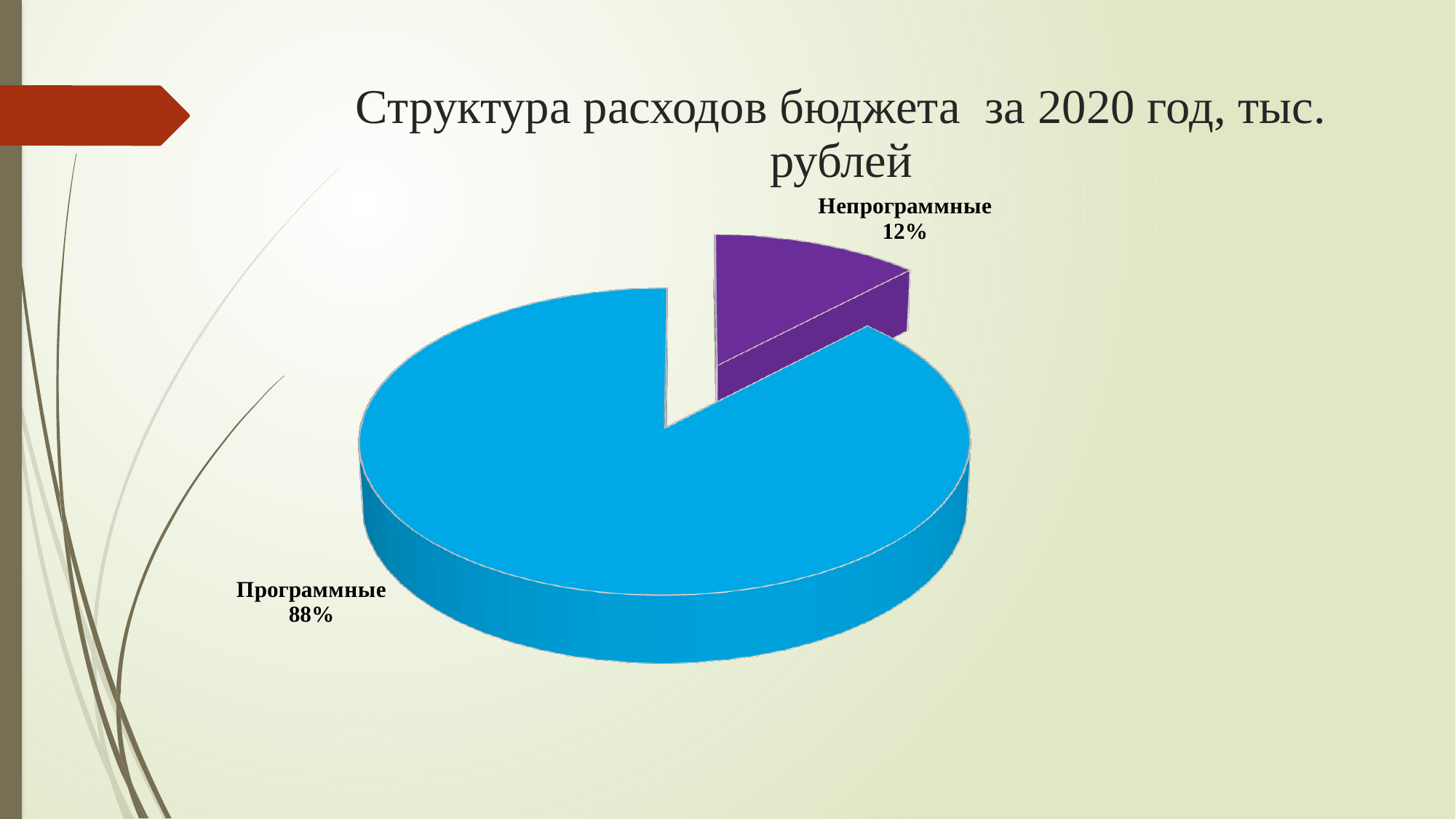
Which slice is the smallest? Непрограммные What is the difference in percentage points between Программные and Непрограммные? 76 What kind of chart is shown on the slide? Pie chart How many slices does the pie chart have? 2 What share of the pie does Непрограммные represent? 12% What colour is the Непрограммные slice? Purple What is the title of the chart? Структура расходов бюджета за 2020 год, тыс. рублей Which slice is the largest? Программные Which is larger, Программные or Непрограммные? Программные What share of the pie does Программные represent? 88%